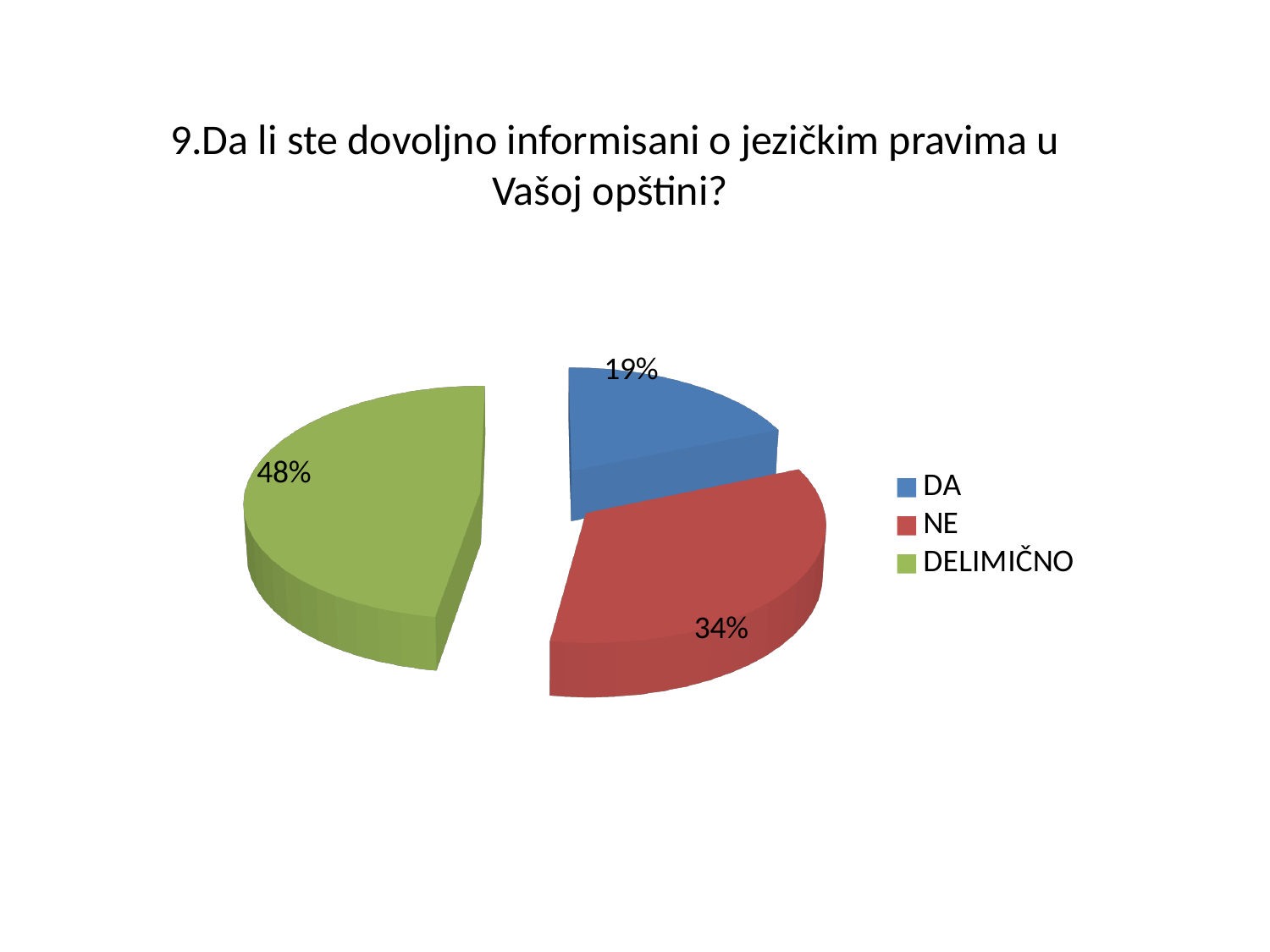
What is the difference in percentage points between DELIMIČNO and NE? 14 What percentage of respondents answered DELIMIČNO? 48% Which answer has the smallest share of the pie? DA Which is larger, the share for NE or the share for DA? NE What percentage of respondents answered DA? 19% What kind of chart is shown on the slide? Pie chart What colour is the slice for DELIMIČNO? Green What is the title of the slide? 9.Da li ste dovoljno informisani o jezičkim pravima u Vašoj opštini? How many categories does the pie chart show? 3 What is the difference in percentage points between NE and DA? 15 What percentage of respondents answered NE? 34% Which answer has the largest share of the pie? DELIMIČNO